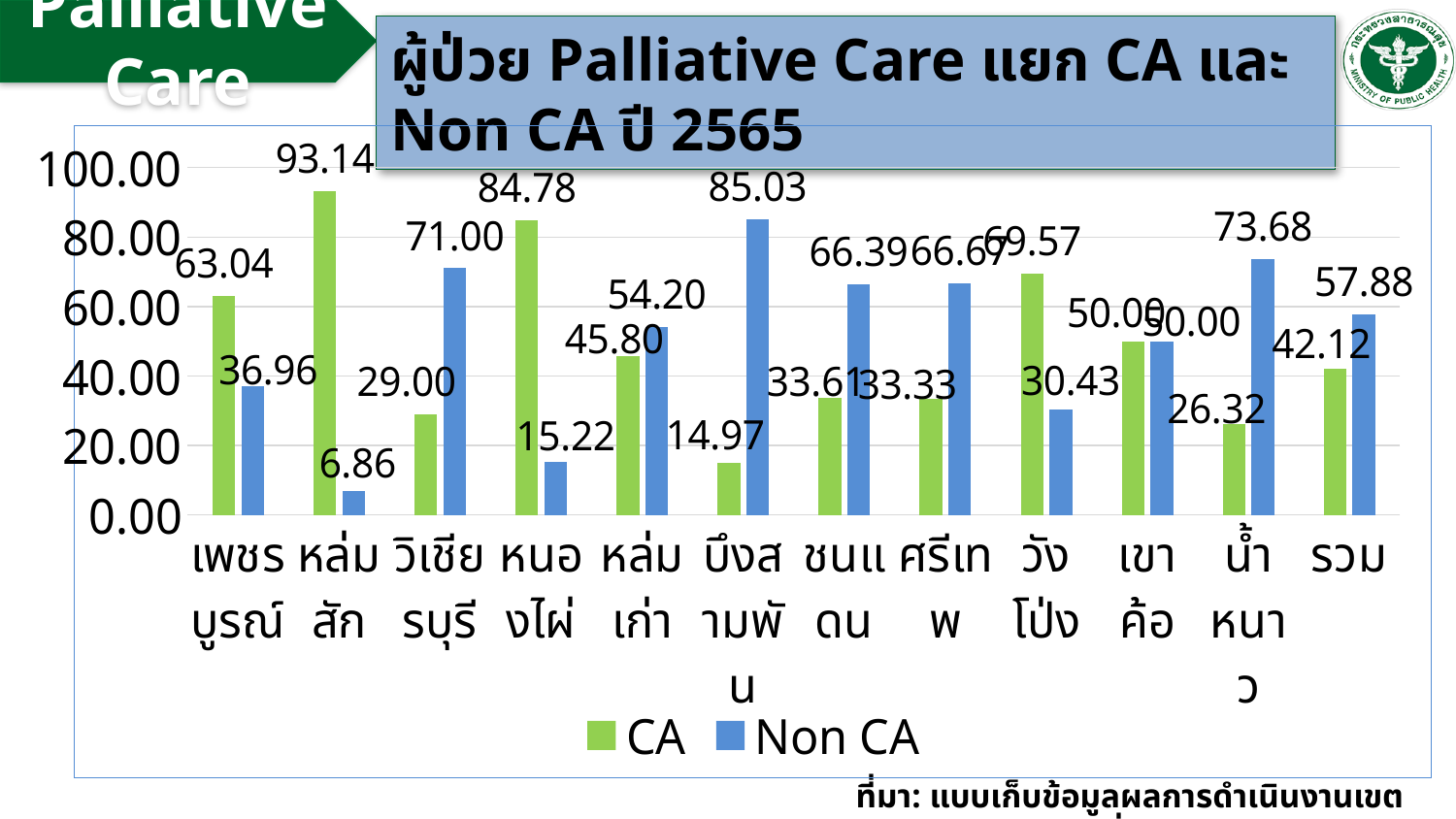
How many series does the legend list? 2 What is the Non CA value for บึงสามพัน? 85.03 What is the difference between the CA and Non CA values for เพชรบูรณ์? 26.08 What is the total of the CA and Non CA values for เขาค้อ? 100.00 Which category has the highest CA value? หล่มสัก What is the CA value for รวม? 42.12 Which colour represents the Non CA series in the legend? blue What is the CA value for หล่มสัก? 93.14 What kind of chart is shown on the slide? bar chart How many categories are shown on the x axis? 12 Which is larger for วิเชียรบุรี, the CA value or the Non CA value? Non CA Which category has the lowest Non CA value? หล่มสัก